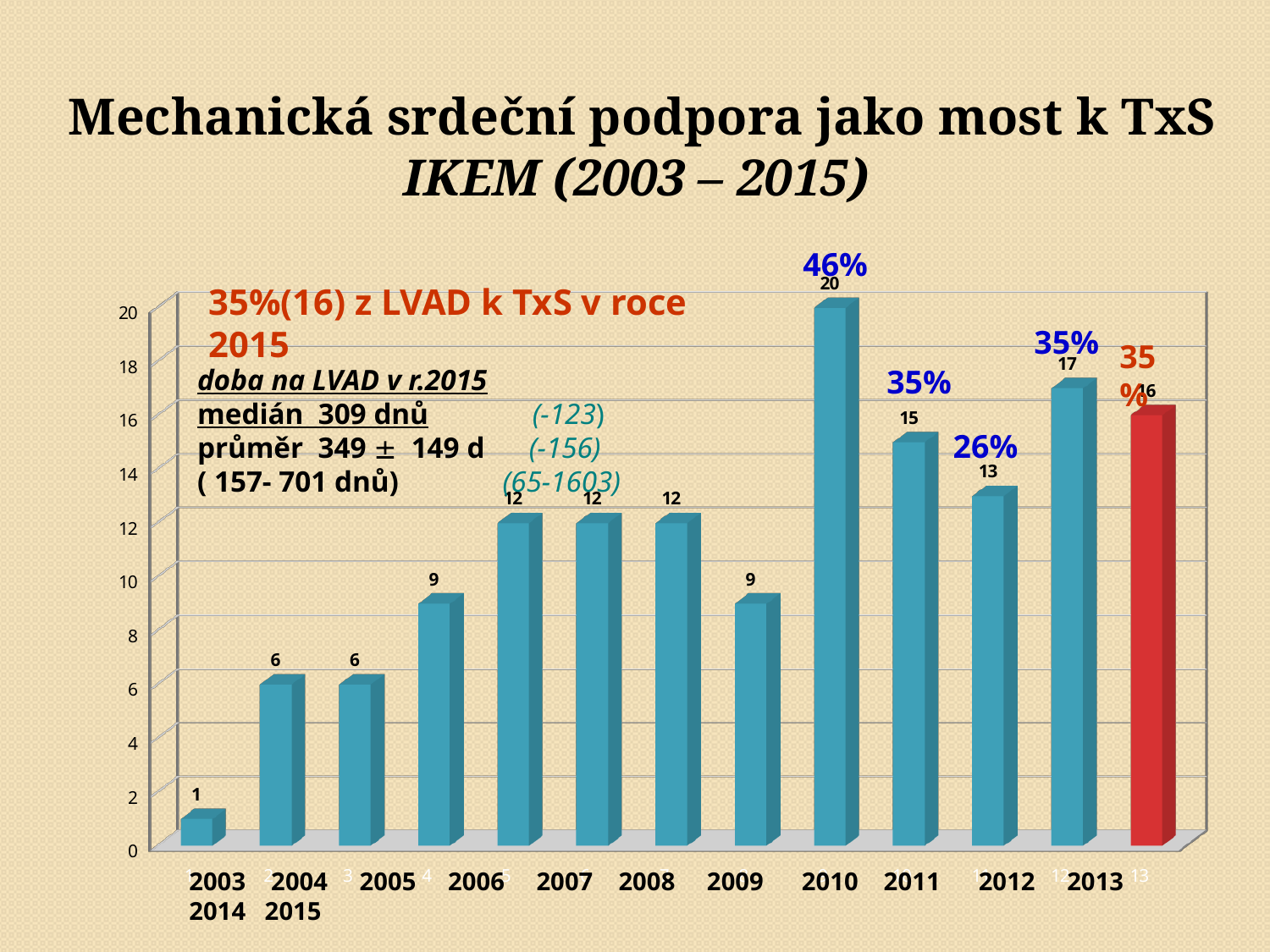
What kind of chart is shown on the slide? bar chart What is the difference between the tallest bar (20) and the red bar (16)? 4 What is the value of the first bar, labelled 2003? 1 Do the values generally rise or fall from the first bar (2003) to the last bar (2015)? rise Which is larger: the tallest blue bar or the red bar? the tallest blue bar What is the value of the tallest bar in the chart? 20 How many bars are plotted in the chart? 13 What percentage is printed in blue above the tallest bar? 46% What is the value shown on the red bar at the right end of the chart? 16 Is the value of the red bar greater or less than 10? greater What is the highest value shown on the vertical axis? 20 What is the value of the shortest bar in the chart? 1